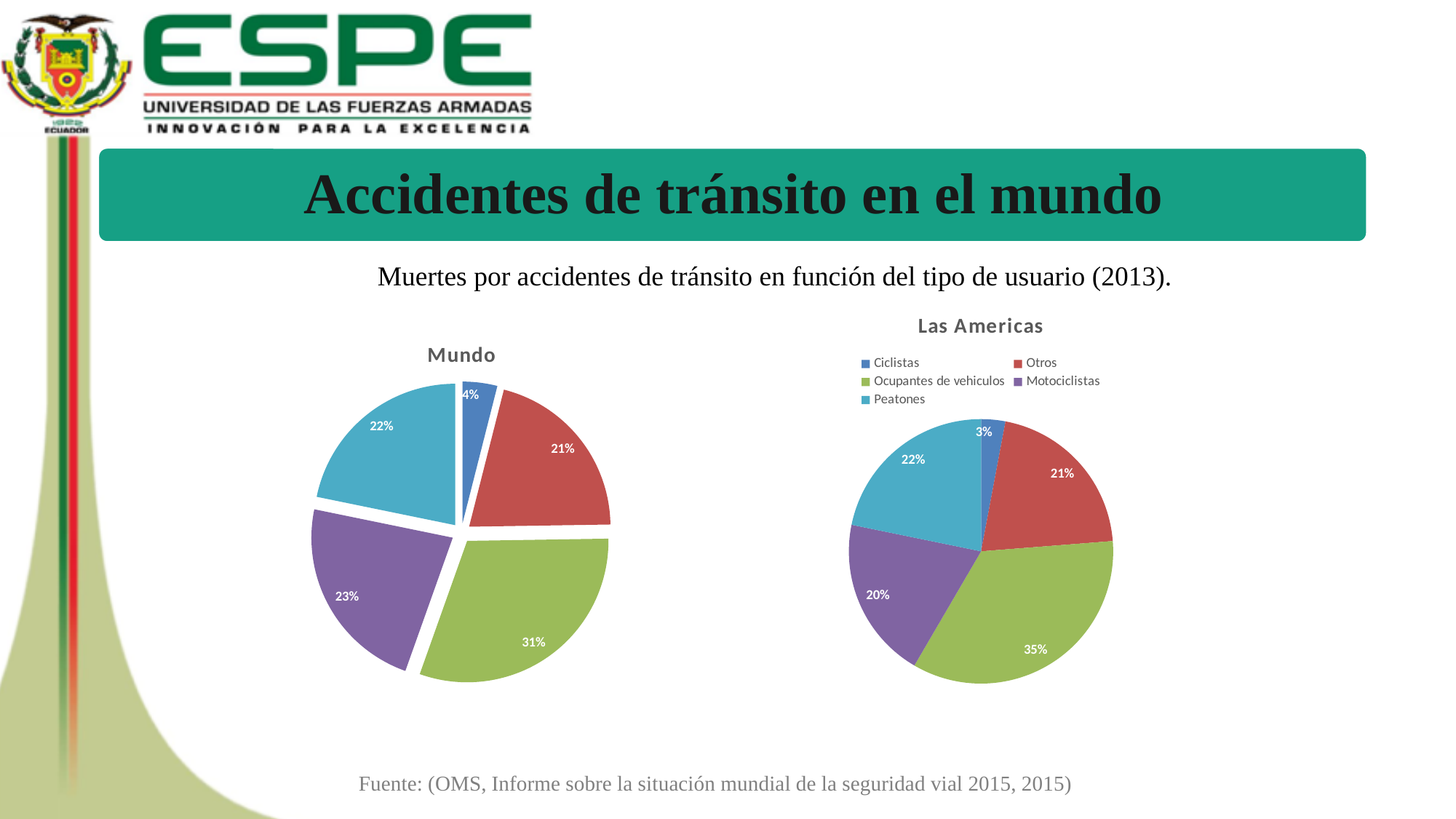
How many entries does the legend of the Las Americas chart list? 5 In the Las Americas chart, which category has the largest slice? Ocupantes de vehiculos In the Las Americas chart, what percentage is shown for Ciclistas? 3% In the Las Americas chart, what share of deaths is attributed to Ocupantes de vehiculos? 35% In the Las Americas chart, which is larger, the slice for Peatones or the slice for Motociclistas? Peatones How many slices does the Mundo pie chart have? 5 In the Mundo chart, what is the largest percentage shown on any slice? 31% What type of chart is the Mundo chart? Pie chart In the Las Americas chart, what percentage is shown for Peatones? 22% In the Las Americas chart, which category has the smallest slice? Ciclistas In the Mundo chart, what percentage is shown on the smallest (blue) slice? 4% In the Las Americas chart, what is the difference in percentage points between Otros and Motociclistas? 1